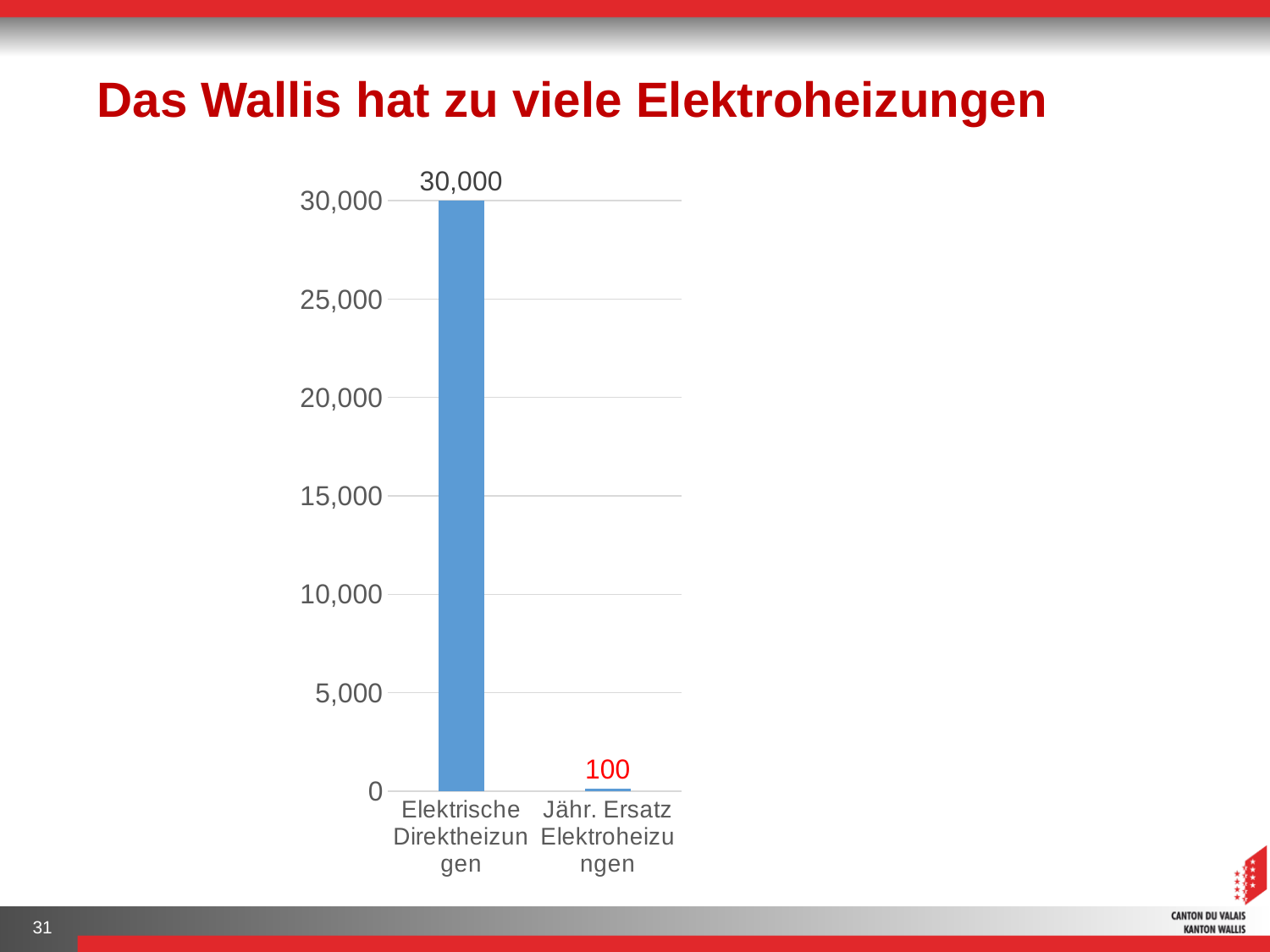
Is the value for Elektrische Direktheizungen greater or less than 25,000? greater How many categories are shown in the chart? 2 Which is larger, the value for Elektrische Direktheizungen or the value for Jähr. Ersatz Elektroheizungen? Elektrische Direktheizungen What is the value for Elektrische Direktheizungen? 30,000 Which category has the highest value? Elektrische Direktheizungen What is the title of the slide? Das Wallis hat zu viele Elektroheizungen What is the highest value shown on the vertical axis? 30,000 Which category has the lowest value? Jähr. Ersatz Elektroheizungen What is the difference between the values for Elektrische Direktheizungen and Jähr. Ersatz Elektroheizungen? 29,900 What is the value for Jähr. Ersatz Elektroheizungen? 100 What kind of chart is shown on the slide? bar chart Is the value for Jähr. Ersatz Elektroheizungen greater or less than 5,000? less